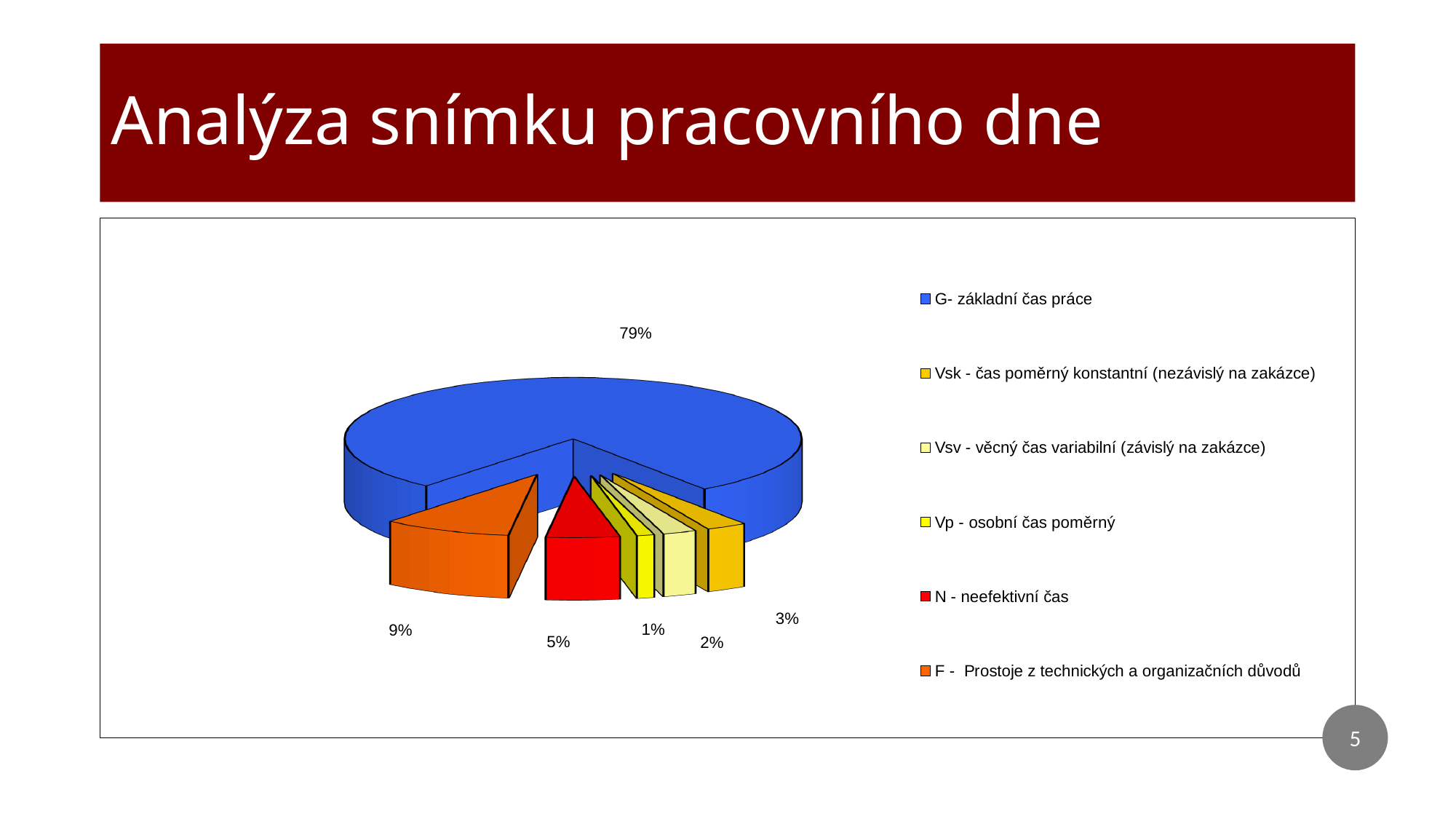
What percentage share does 'Vsk - čas poměrný konstantní (nezávislý na zakázce)' have in the pie chart? 3% What percentage share does 'G- základní čas práce' have in the pie chart? 79% Which is larger in the pie chart: 'N - neefektivní čas' or 'Vsv - věcný čas variabilní (závislý na zakázce)'? N - neefektivní čas What kind of chart is shown on the slide? pie chart How many categories does the legend of the pie chart list? 6 Which category has the largest slice in the pie chart? G- základní čas práce Which category has the smallest slice in the pie chart? Vp - osobní čas poměrný What percentage share does 'F - Prostoje z technických a organizačních důvodů' have in the pie chart? 9% What is the difference in percentage points between 'G- základní čas práce' and 'F - Prostoje z technických a organizačních důvodů'? 70 What percentage share does 'N - neefektivní čas' have in the pie chart? 5% What percentage share does 'Vp - osobní čas poměrný' have in the pie chart? 1% What colour is the slice for 'G- základní čas práce' in the pie chart? blue